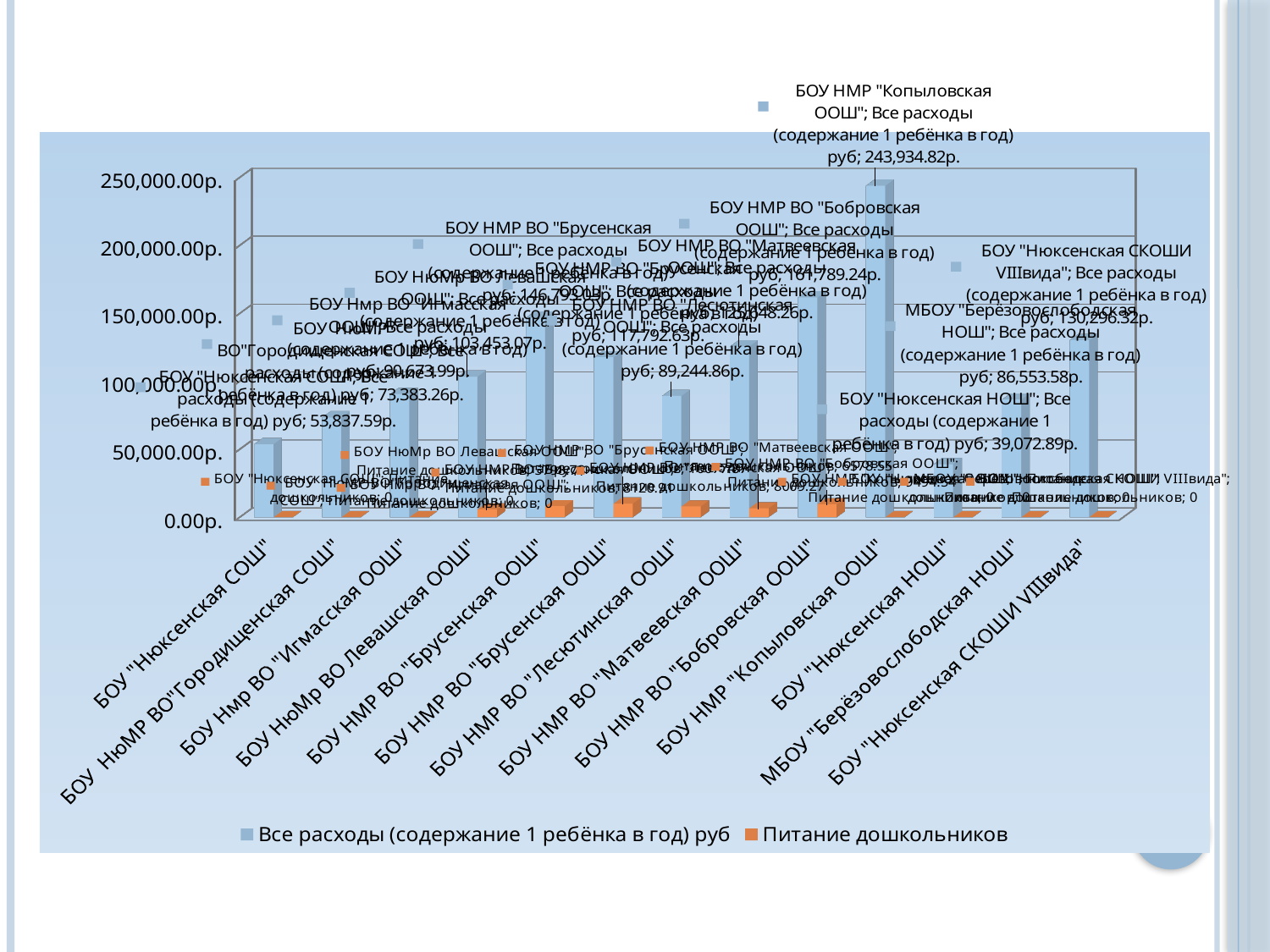
Is the value of 'Все расходы (содержание 1 ребёнка в год) руб' for БОУ "Нюксенская СОШ" greater or less than 100,000.00р.? less What is the value of 'Все расходы (содержание 1 ребёнка в год) руб' for БОУ НМР "Копыловская ООШ"? 243,934.82р. What is the value of 'Все расходы (содержание 1 ребёнка в год) руб' for МБОУ "Березовослободская НОШ"? 86,553.58р. What kind of chart is shown on the slide? bar chart How many series does the legend list? 2 What is the value of 'Все расходы (содержание 1 ребёнка в год) руб' for БОУ НМР ВО "Бобровская ООШ"? 161,789.24р. What is the difference in 'Все расходы (содержание 1 ребёнка в год) руб' between БОУ НМР "Копыловская ООШ" and БОУ НМР ВО "Бобровская ООШ"? 82,145.58р. What is the value of 'Все расходы (содержание 1 ребёнка в год) руб' for БОУ "Нюксенская НОШ"? 39,072.89р. What is the value of 'Все расходы (содержание 1 ребёнка в год) руб' for БОУ "Нюксенская СКОШИ VIIIвида"? 130,296.32р. Which school has the highest value for 'Все расходы (содержание 1 ребёнка в год) руб'? БОУ НМР "Копыловская ООШ" Which is larger for 'Все расходы (содержание 1 ребёнка в год) руб': БОУ "Нюксенская СКОШИ VIIIвида" or МБОУ "Березовослободская НОШ"? БОУ "Нюксенская СКОШИ VIIIвида" How many schools (categories) are shown on the x axis? 13